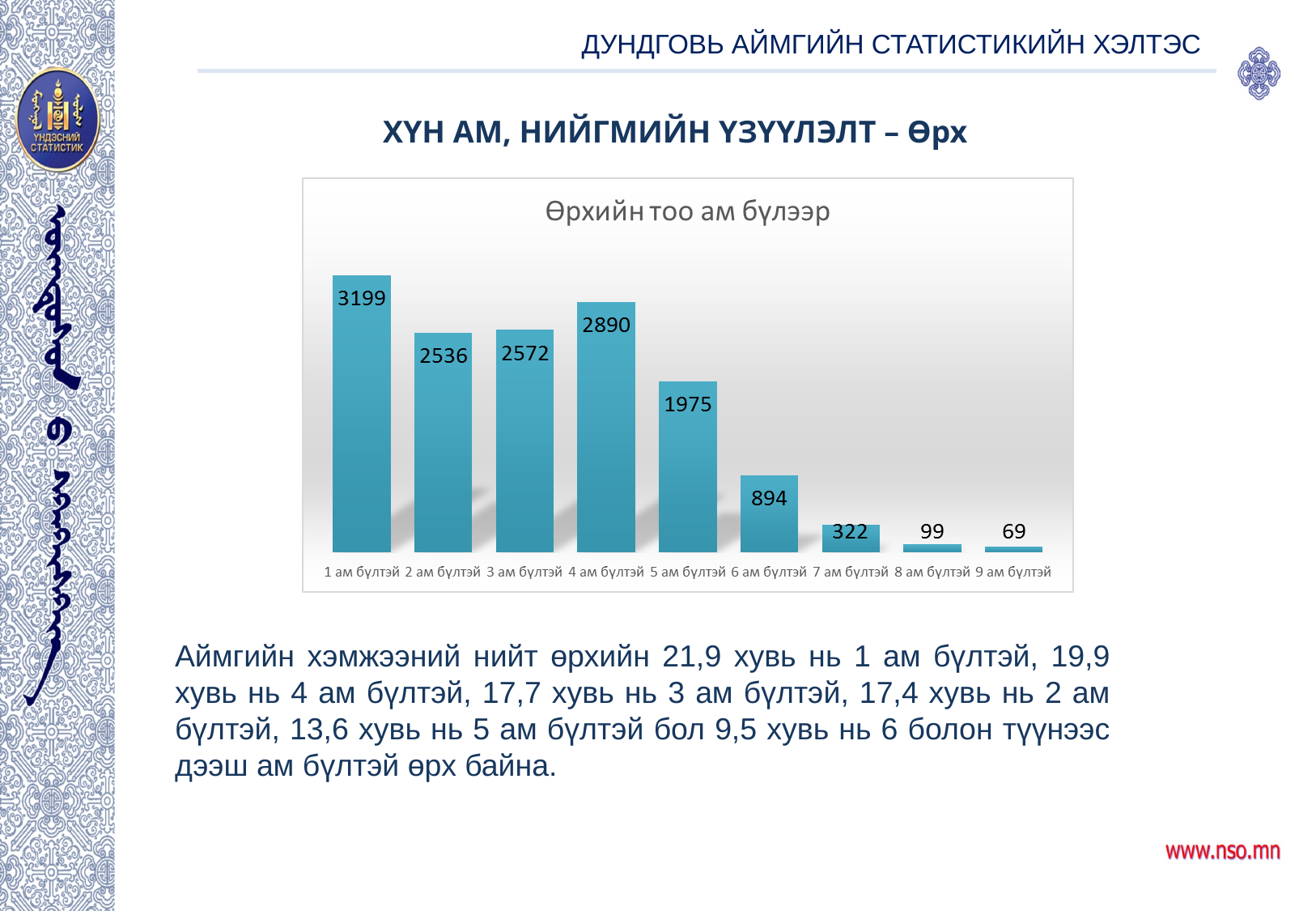
How many categories are shown on the chart? 9 Which category has the highest value? 1 ам бүлтэй What is the value for 1 ам бүлтэй? 3199 What is the difference between the values for 6 ам бүлтэй and 7 ам бүлтэй? 572 What is the value for 8 ам бүлтэй? 99 What is the title of the chart? Өрхийн тоо ам бүлээр Which is larger, the value for 2 ам бүлтэй or 3 ам бүлтэй? 3 ам бүлтэй What is the difference between the values for 1 ам бүлтэй and 4 ам бүлтэй? 309 What kind of chart is shown on the slide? Bar chart What is the value for 5 ам бүлтэй? 1975 Which category has the lowest value? 9 ам бүлтэй Which is larger, the value for 4 ам бүлтэй or 5 ам бүлтэй? 4 ам бүлтэй